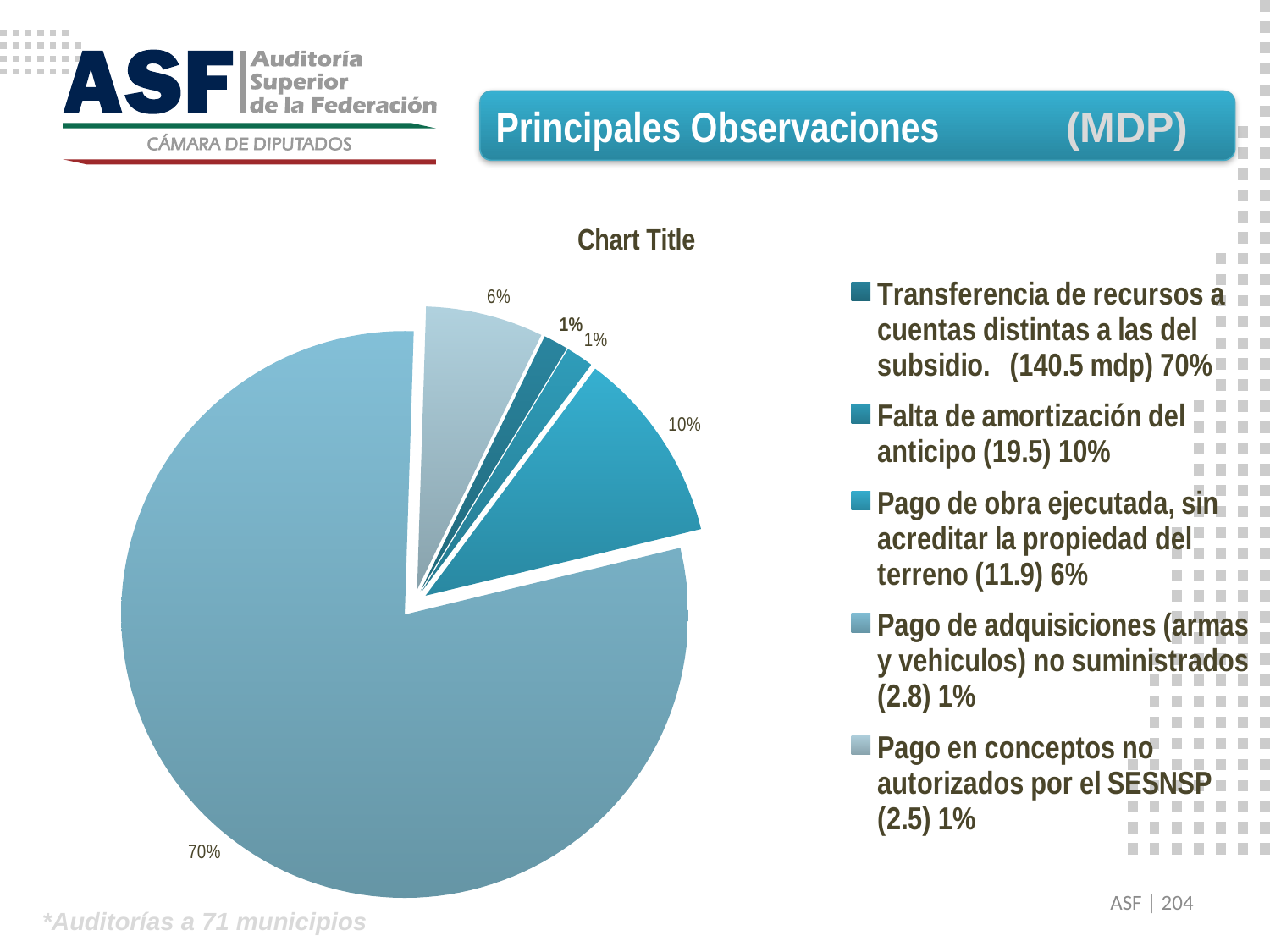
What is the difference in mdp between "Transferencia de recursos a cuentas distintas a las del subsidio" (140.5) and "Falta de amortización del anticipo" (19.5)? 121.0 What amount in mdp is shown in the legend for "Pago en conceptos no autorizados por el SESNSP"? 2.5 Which category has the largest slice of the pie? Transferencia de recursos a cuentas distintas a las del subsidio Which is larger: the amount for "Pago de adquisiciones (armas y vehiculos) no suministrados" or for "Pago en conceptos no autorizados por el SESNSP"? Pago de adquisiciones (armas y vehiculos) no suministrados How many slices does the pie chart have? 5 What share of the pie does "Transferencia de recursos a cuentas distintas a las del subsidio" represent? 70% What title is printed above the pie chart? Chart Title What share of the pie does "Falta de amortización del anticipo" represent? 10% What kind of chart is shown on the slide? pie chart What share of the pie does "Pago de obra ejecutada, sin acreditar la propiedad del terreno" represent? 6% What amount in mdp is shown in the legend for "Falta de amortización del anticipo"? 19.5 How many entries does the legend of the pie chart list? 5